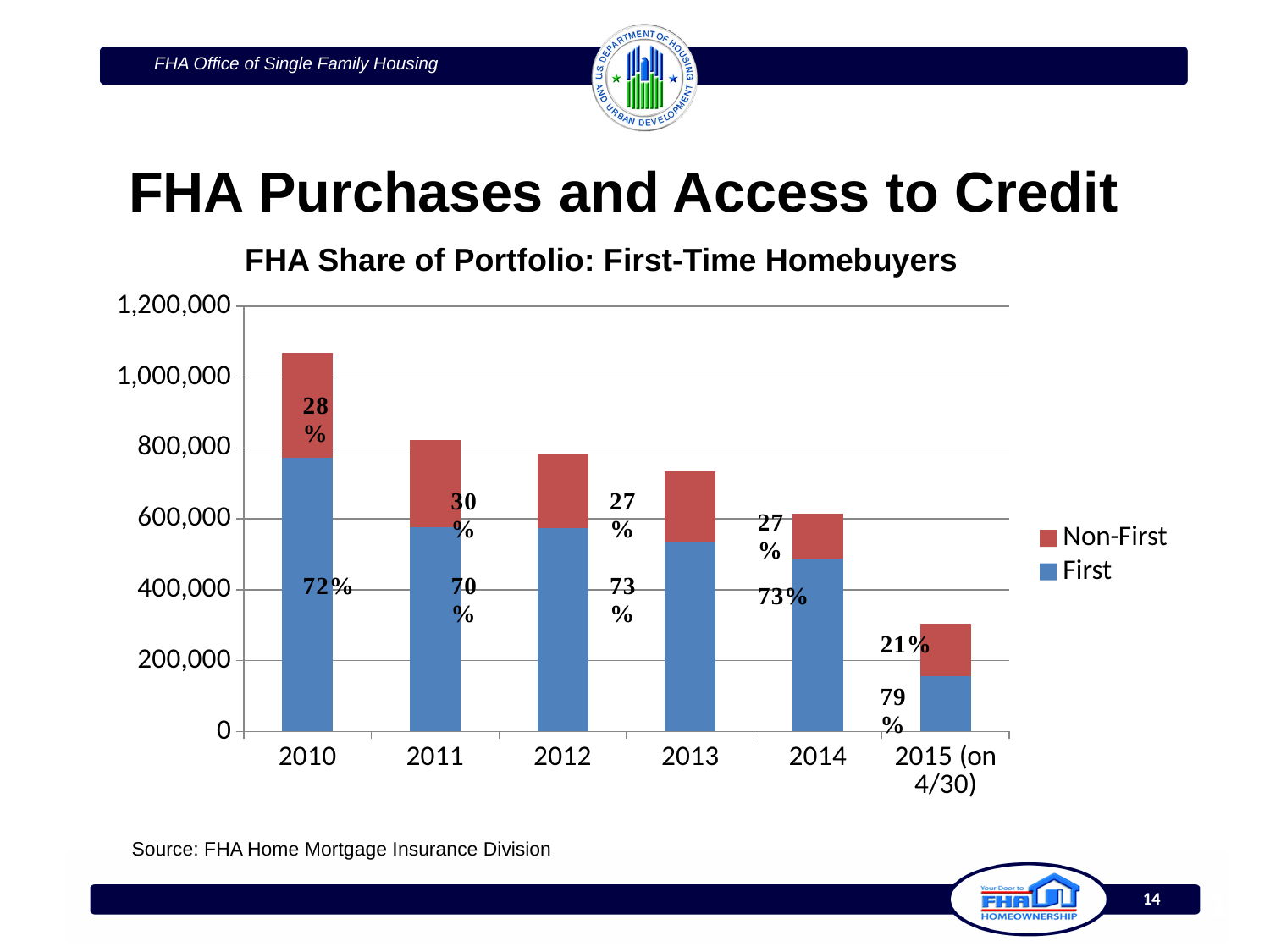
Which category has the shortest total bar? 2015 (on 4/30) What kind of chart is shown on the slide? Stacked bar chart Which year has the tallest total bar? 2010 What percentage share is labelled for First in 2015 (on 4/30)? 79% How many series does the legend list? 2 Do the total bar heights generally rise or fall from 2010 to 2015? Fall Is the total bar for 2010 greater or less than 1,000,000? greater What percentage share is labelled for Non-First in 2011? 30% What percentage share is labelled for First in 2010? 72% What is the title of the chart? FHA Share of Portfolio: First-Time Homebuyers How many year categories are shown on the x axis? 6 What percentage share is labelled for Non-First in 2010? 28%